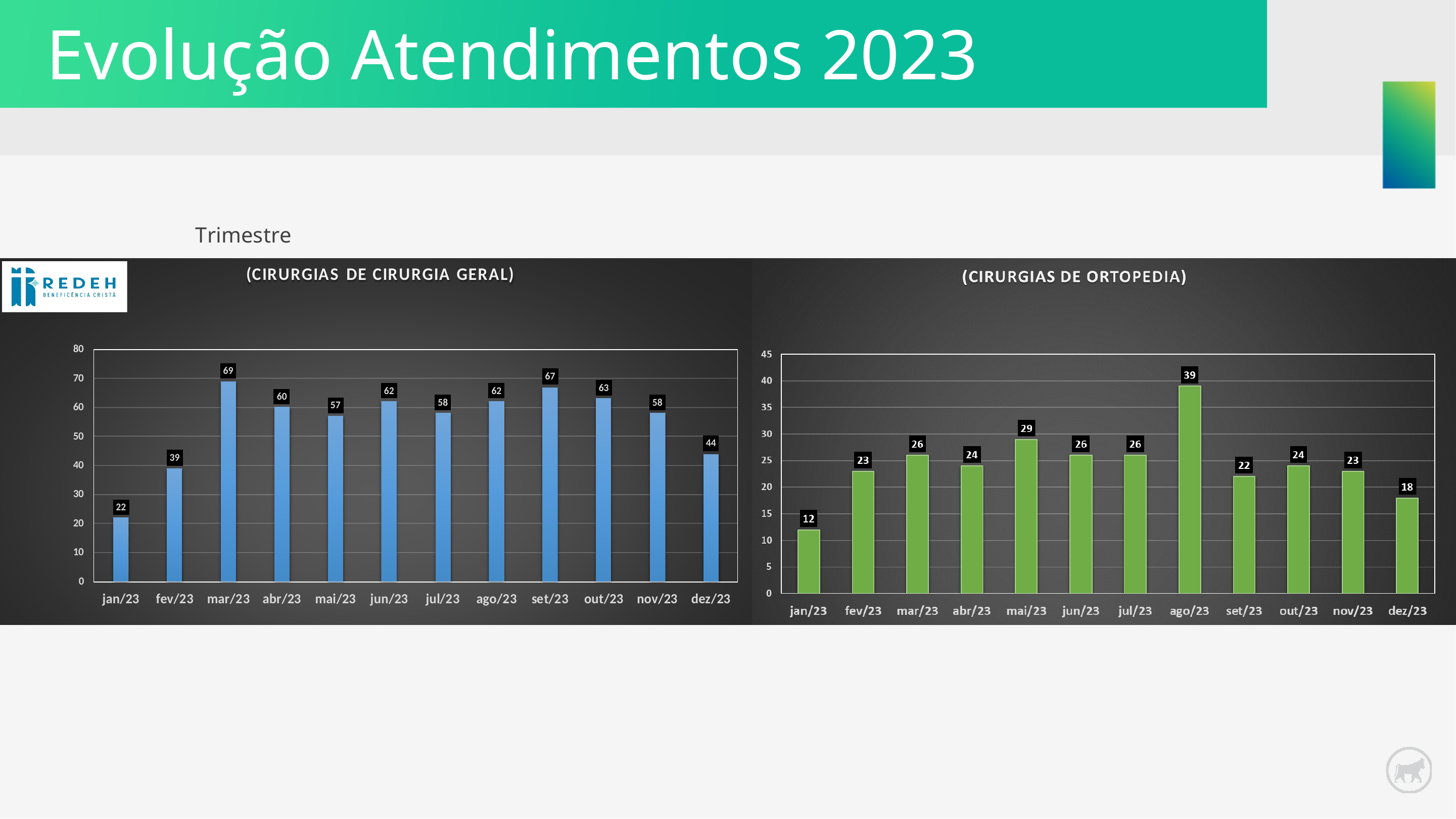
How many months are shown on the x axis of the CIRURGIAS DE CIRURGIA GERAL chart? 12 In the CIRURGIAS DE ORTOPEDIA chart, what is the difference between the values for mai/23 and dez/23? 11 In the CIRURGIAS DE CIRURGIA GERAL chart, which month has the lowest value? jan/23 What kind of chart is the CIRURGIAS DE ORTOPEDIA chart? bar chart In the CIRURGIAS DE ORTOPEDIA chart, what is the value for ago/23? 39 In the CIRURGIAS DE ORTOPEDIA chart, which month has the lowest value? jan/23 In the CIRURGIAS DE ORTOPEDIA chart, is the value for jan/23 greater or less than 15? less In the CIRURGIAS DE CIRURGIA GERAL chart, what is the value for mar/23? 69 What colour are the bars in the CIRURGIAS DE CIRURGIA GERAL chart? blue In the CIRURGIAS DE CIRURGIA GERAL chart, what is the difference between the values for set/23 and dez/23? 23 In the CIRURGIAS DE CIRURGIA GERAL chart, which is larger, the value for abr/23 or the value for mai/23? abr/23 In the CIRURGIAS DE ORTOPEDIA chart, which month has the highest value? ago/23